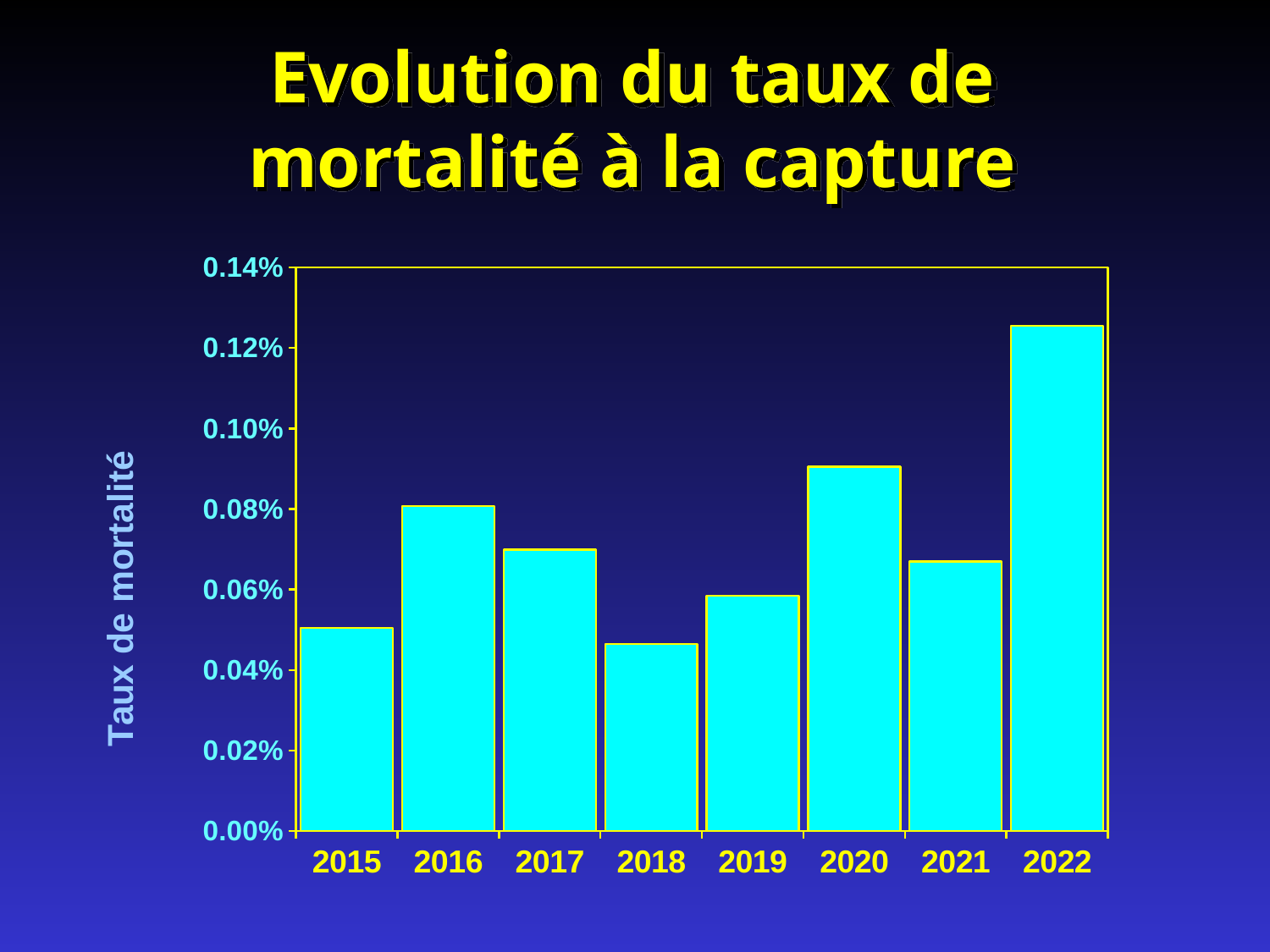
What is the label of the vertical axis? Taux de mortalité Is the value for 2022 greater or less than 0.12%? greater What kind of chart is shown on the slide? bar chart Which is larger, the value for 2020 or the value for 2021? 2020 What is the title of the slide? Evolution du taux de mortalité à la capture Is the value for 2021 greater or less than 0.08%? less Is the value for 2020 greater or less than 0.08%? greater How many years are shown on the x axis of the chart? 8 Which year has the highest mortality rate in the chart? 2022 Which is larger, the value for 2016 or the value for 2017? 2016